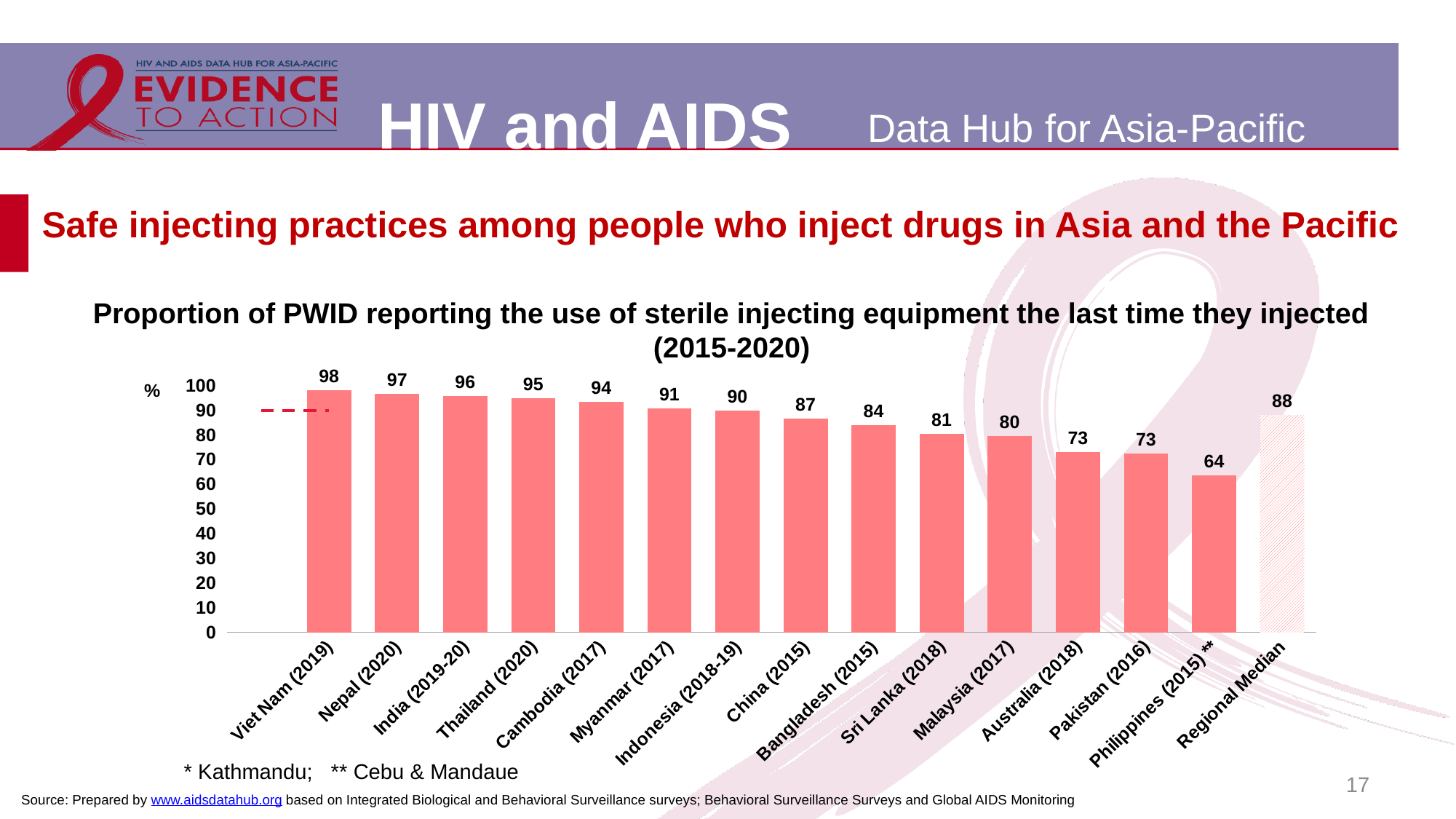
What is the value for Viet Nam (2019)? 98 Do the country values rise or fall from left to right along the x axis? Fall Which country has the highest proportion of PWID reporting use of sterile injecting equipment? Viet Nam (2019) How many country bars are shown on the chart, excluding the Regional Median? 14 What is the difference between the values for China (2015) and Malaysia (2017)? 7 What kind of chart is shown on the slide? Bar chart What is the value for Philippines (2015) **? 64 Which is larger, the value for Myanmar (2017) or the value for Bangladesh (2015)? Myanmar (2017) Which country has the lowest proportion of PWID reporting use of sterile injecting equipment? Philippines (2015) ** Is the value for Sri Lanka (2018) greater or less than the Regional Median? less What is the Regional Median value shown on the chart? 88 What is the difference between the values for Viet Nam (2019) and Philippines (2015) **? 34